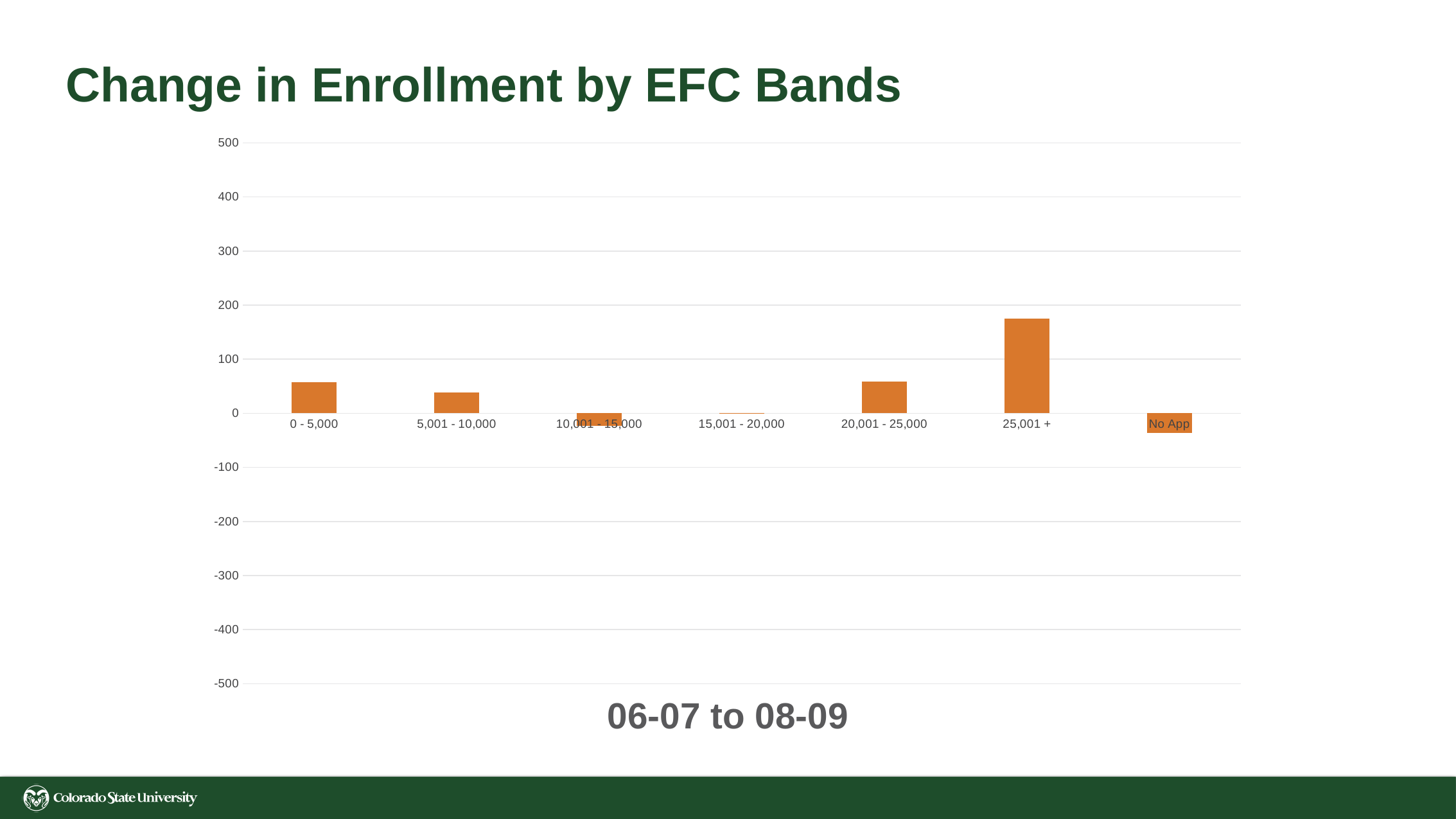
Is the value for 0 - 5,000 greater or less than 100? less Is the value for No App greater or less than 0? less What time period is shown beneath the chart? 06-07 to 08-09 Which category has the lowest change in enrollment? No App How many EFC band categories are plotted on the x axis? 7 Is the value for 25,001 + greater or less than 200? less What is the title of the chart? Change in Enrollment by EFC Bands Which is larger, the value for 25,001 + or the value for 5,001 - 10,000? 25,001 + How many categories have a negative change in enrollment? 2 What kind of chart is shown on the slide? Bar chart Which EFC band has the highest change in enrollment? 25,001 +